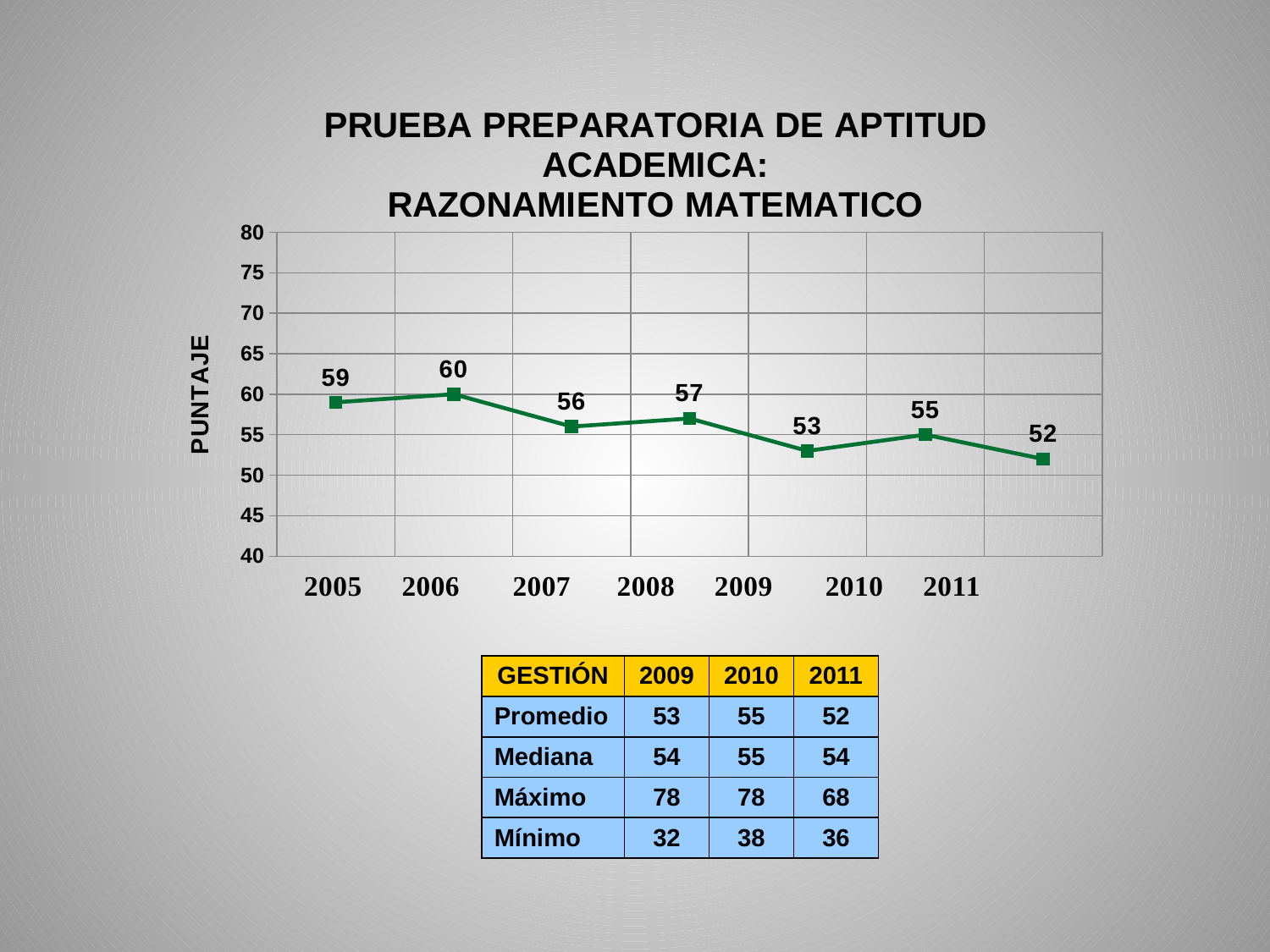
Do the values generally rise or fall from 2005 to 2011? fall What is the value for 2011? 52 Which year has the highest value? 2006 Which year has the lowest value? 2011 Which is larger, the value for 2008 or the value for 2010? 2008 How many years are plotted on the chart? 7 What is the value for 2005? 59 What is the value for 2009? 53 What is the difference between the values for 2006 and 2011? 8 What kind of chart is shown? line chart What is the label on the vertical axis? PUNTAJE Is the value for 2009 greater or less than 55? less